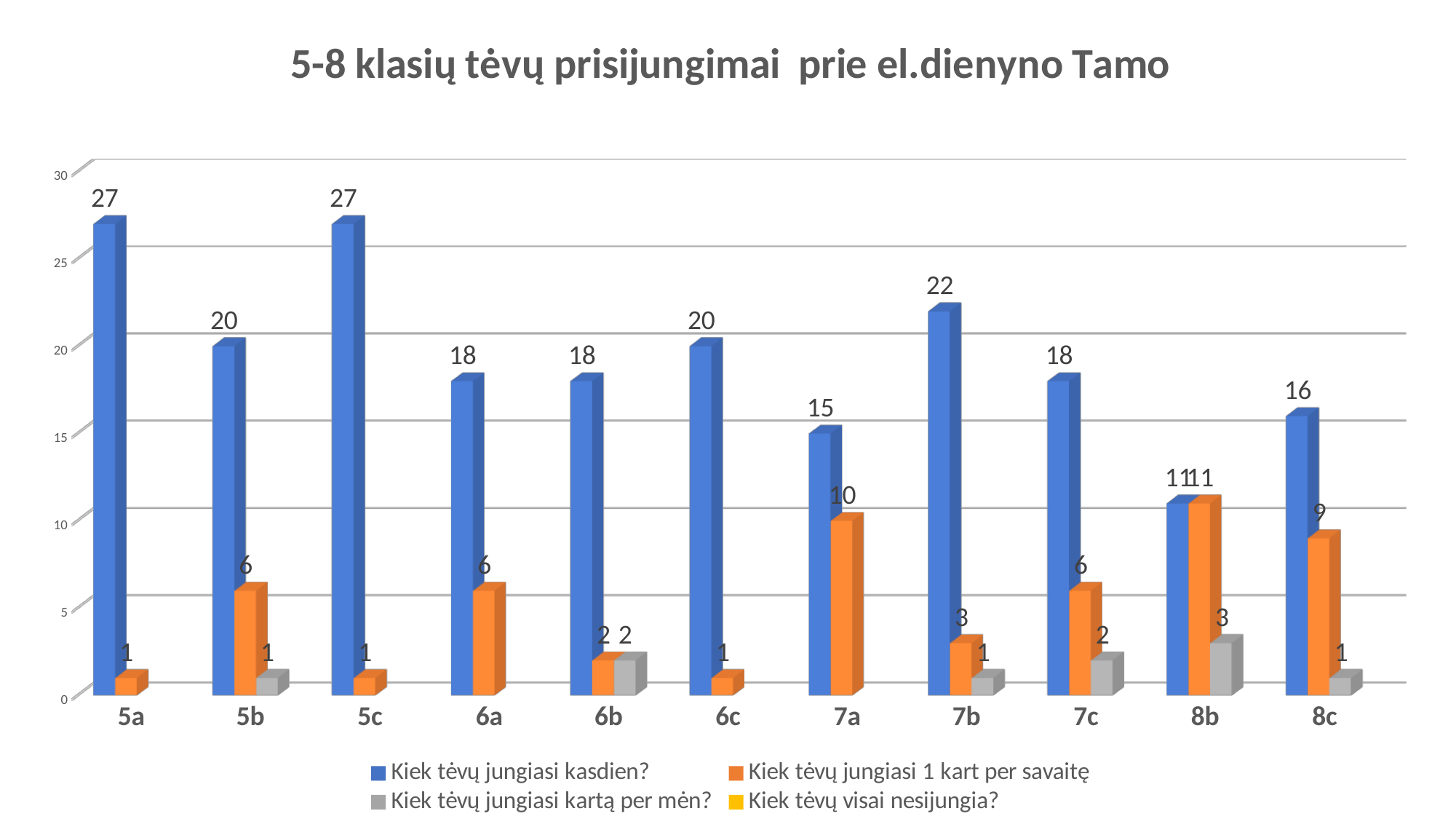
How many series does the legend list? 4 What is the value of 'Kiek tėvų jungiasi kasdien?' for class 7b? 22 What is the value of 'Kiek tėvų jungiasi 1 kart per savaitę' for class 7a? 10 Which class has the lowest value for 'Kiek tėvų jungiasi kasdien?'? 8b What is the title of the chart? 5-8 klasių tėvų prisijungimai prie el.dienyno Tamo How many class categories are shown on the x axis? 11 What is the value of 'Kiek tėvų jungiasi kartą per mėn?' for class 8b? 3 Which is larger: the 'Kiek tėvų jungiasi kasdien?' value for 6c or for 8c? 6c Is the 'Kiek tėvų jungiasi kasdien?' value for 7a greater or less than 20? less Which class has the highest value for 'Kiek tėvų jungiasi 1 kart per savaitę'? 8b What is the difference between the 'Kiek tėvų jungiasi kasdien?' values for 5a and 5b? 7 What type of chart is shown on the slide? bar chart